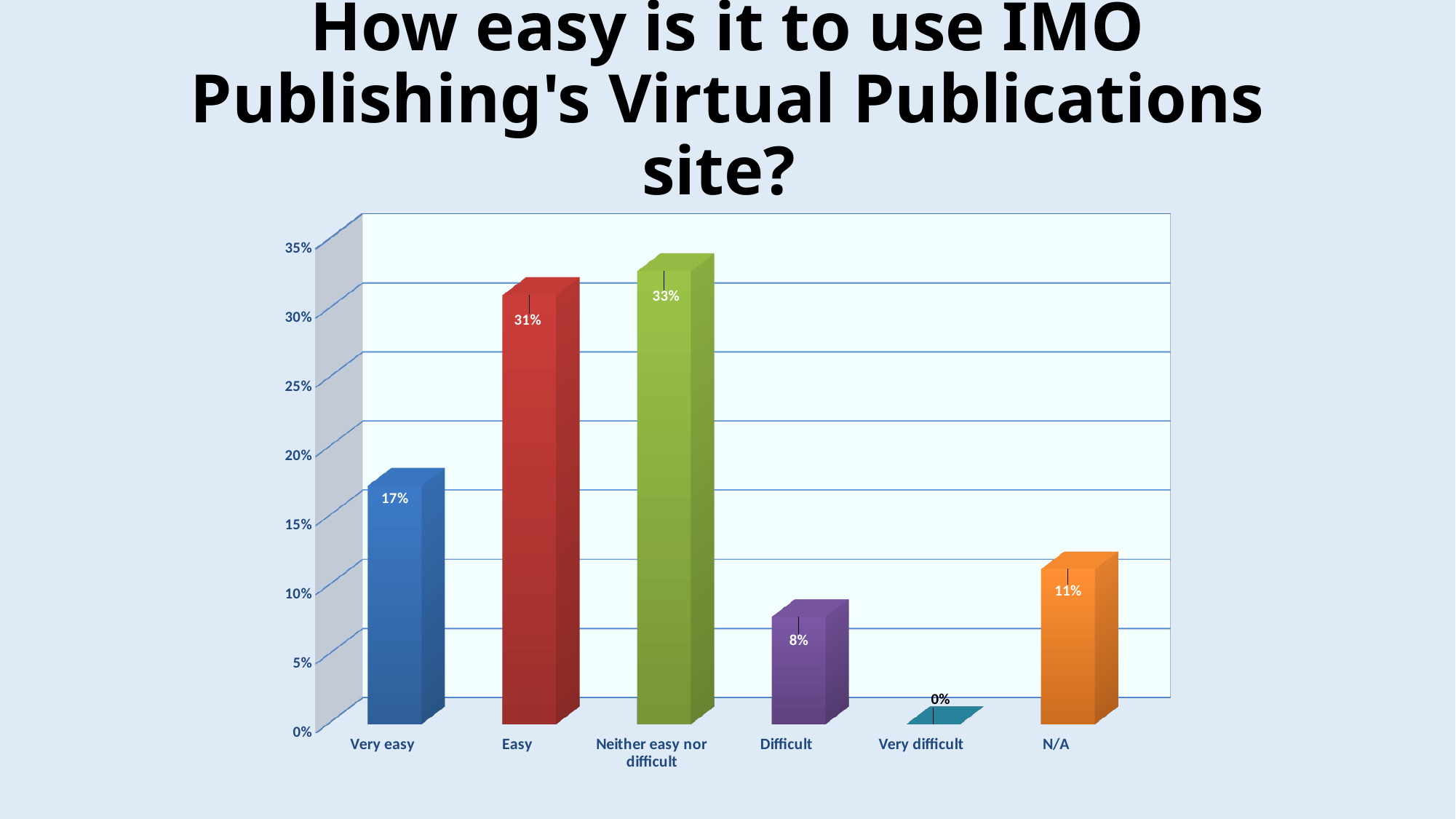
What percentage of respondents said the site was "Very easy" to use? 17% What is the value shown for the "Easy" category? 31% What is the difference between the "Neither easy nor difficult" and "Easy" values? 2% What is the difference between the "Very easy" and "Difficult" values? 9% Which category has the lowest value? Very difficult What is the title of the chart? How easy is it to use IMO Publishing's Virtual Publications site? Which is larger, the value for "Very easy" or the value for "N/A"? Very easy What is the value for "Very difficult"? 0% Which category has the highest value? Neither easy nor difficult How many categories are shown on the x axis? 6 What percentage is shown for "N/A"? 11% What kind of chart is shown on the slide? Bar chart